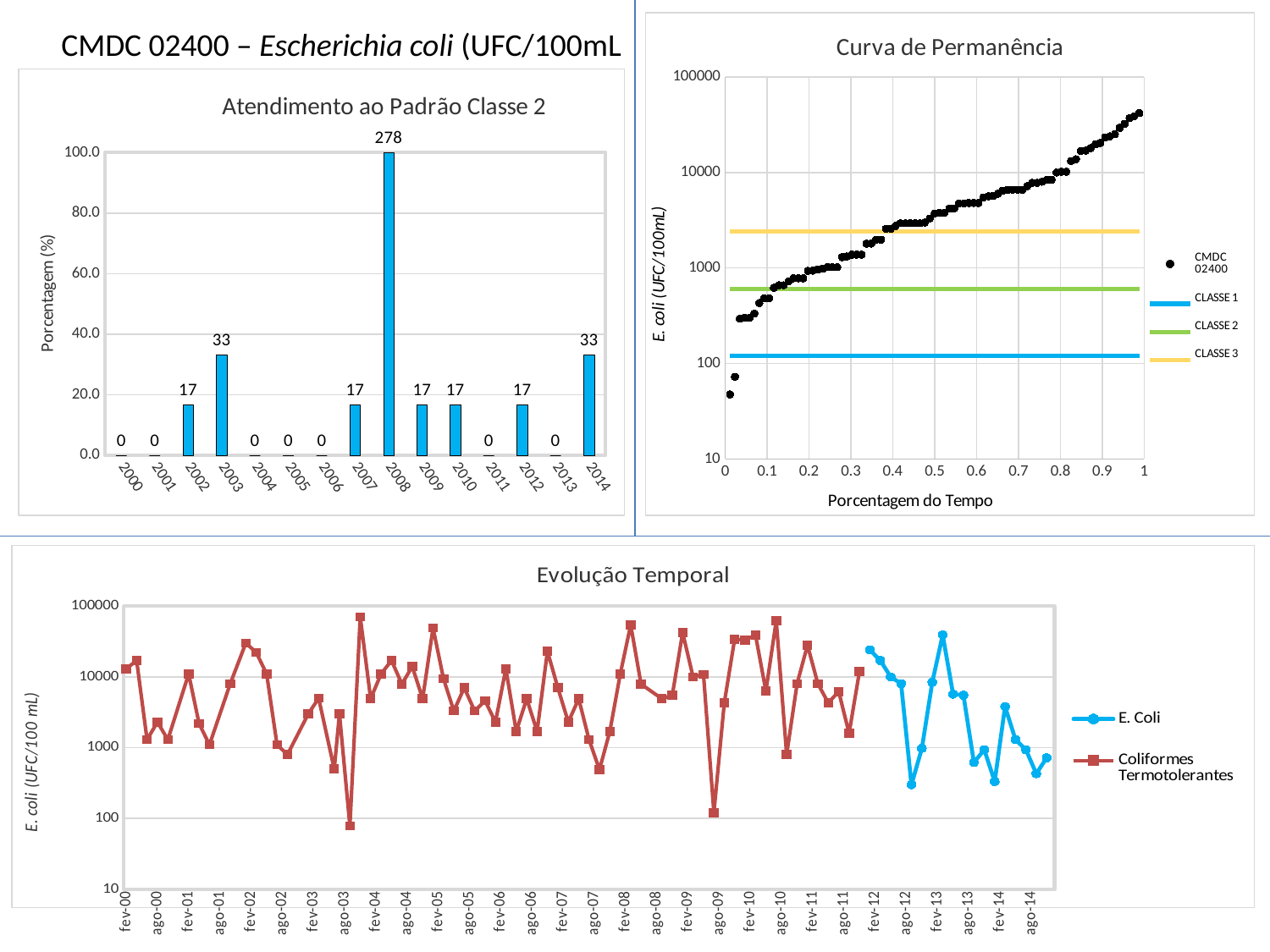
How many years are shown on the x axis of the 'Atendimento ao Padrão Classe 2' chart? 15 How many entries does the legend of the 'Curva de Permanência' chart list? 4 What kind of chart is 'Atendimento ao Padrão Classe 2'? Bar chart In the 'Atendimento ao Padrão Classe 2' chart, what is the value for 2003? 33 In the 'Atendimento ao Padrão Classe 2' chart, what is the value for 2007? 17 How many series does the legend of the 'Evolução Temporal' chart list? 2 In the 'Atendimento ao Padrão Classe 2' chart, what is the difference between the values for 2003 and 2002? 16 In the 'Evolução Temporal' chart, which colour is used for the E. Coli series? Blue In the 'Curva de Permanência' chart, is the CLASSE 2 line greater or less than 1000? less In the 'Atendimento ao Padrão Classe 2' chart, which is larger, the value for 2014 or the value for 2012? 2014 In the 'Atendimento ao Padrão Classe 2' chart, which year has the highest bar? 2008 In the 'Curva de Permanência' chart, do the CMDC 02400 values rise or fall as Porcentagem do Tempo increases? Rise